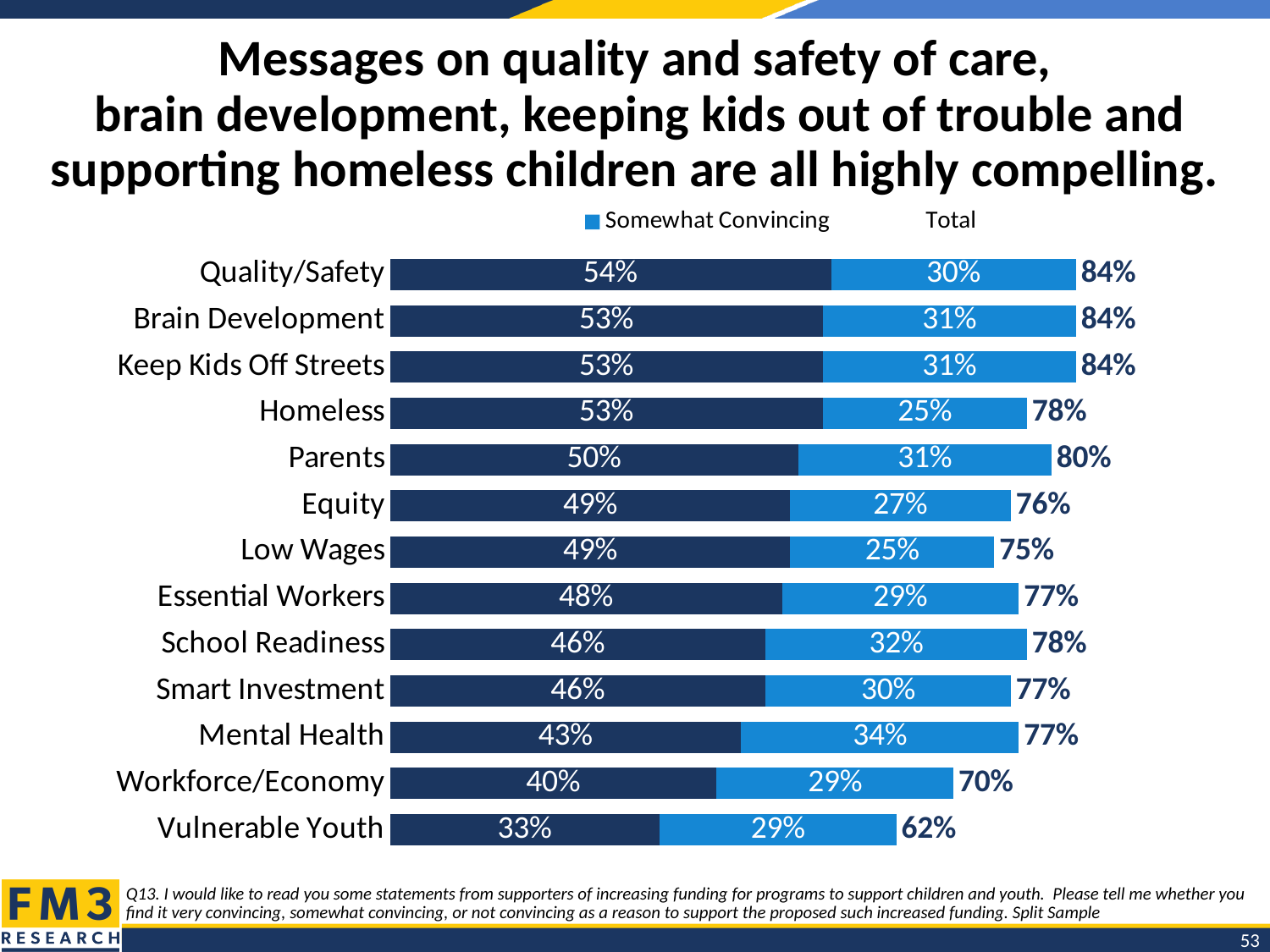
What is the Total value shown for the Homeless bar? 78% Which message has the highest value in the dark blue segment? Quality/Safety Which has a larger Somewhat Convincing value, School Readiness or Homeless? School Readiness Which message has the highest Somewhat Convincing value? Mental Health Which message has the lowest Total value? Vulnerable Youth What is the difference between the Total for Quality/Safety and the Total for Workforce/Economy? 14 percentage points What is the Somewhat Convincing value for Mental Health? 34% What kind of chart is shown on the slide? Stacked bar chart What is the value of the dark blue segment for Vulnerable Youth? 33% How many messages are listed in the chart? 13 What is the difference between the Somewhat Convincing values for Mental Health and Low Wages? 9 percentage points What is the Total value shown for Parents? 80%